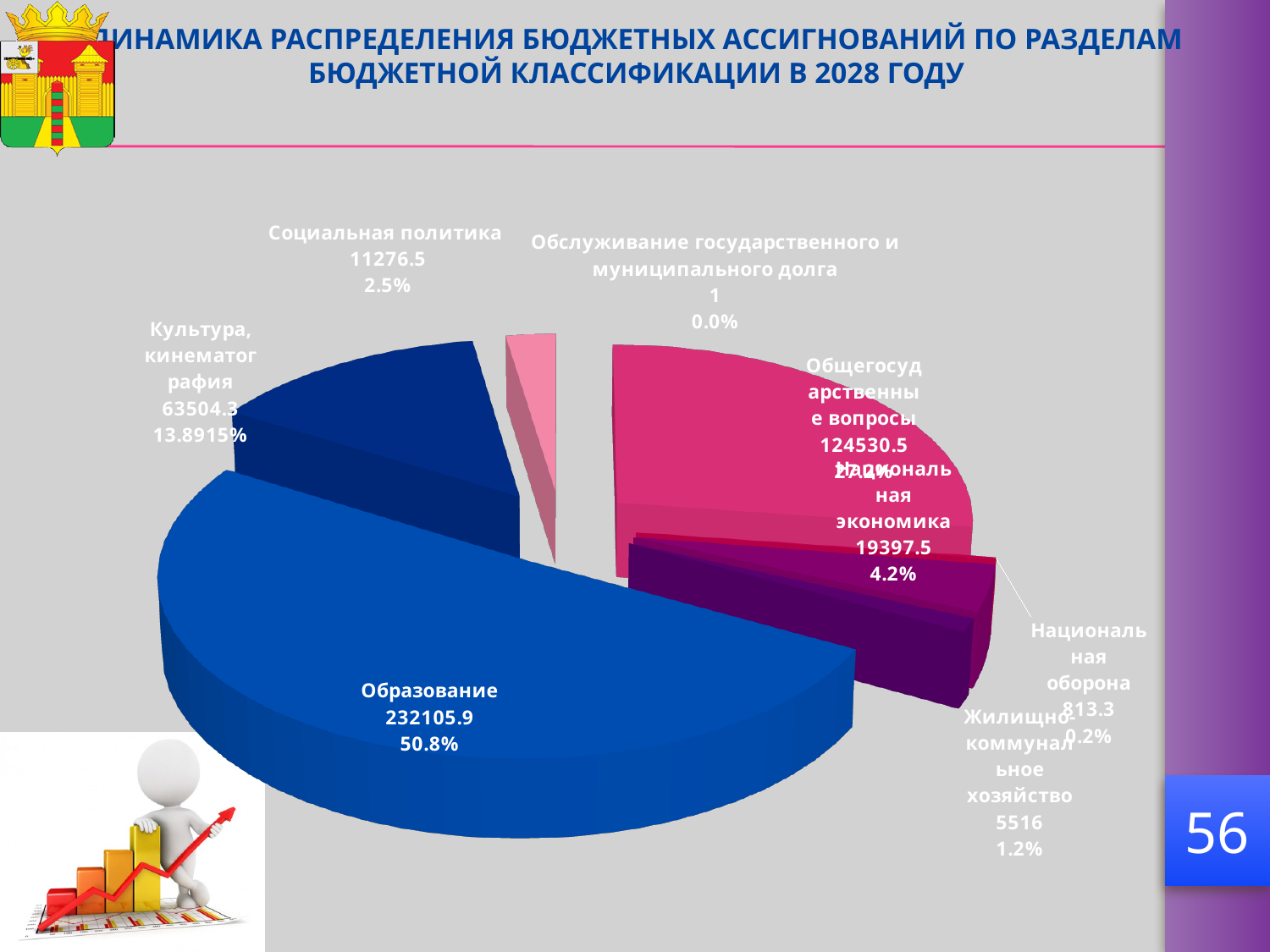
What share of the pie does Образование represent? 50.8% How many categories (slices) does the pie chart show? 8 Which category has the largest value in the pie chart? Образование What kind of chart is shown on the slide? pie chart What is the value shown for Образование? 232105.9 Which is larger: Национальная экономика or Жилищно-коммунальное хозяйство? Национальная экономика Which year does the chart title refer to? 2028 What share of the pie does Социальная политика represent? 2.5% What is the value shown for Культура, кинематография? 63504.3 What is the difference between the values for Образование and Культура, кинематография? 168601.6 Which category has the smallest value in the pie chart? Обслуживание государственного и муниципального долга What is the value shown for Национальная экономика? 19397.5